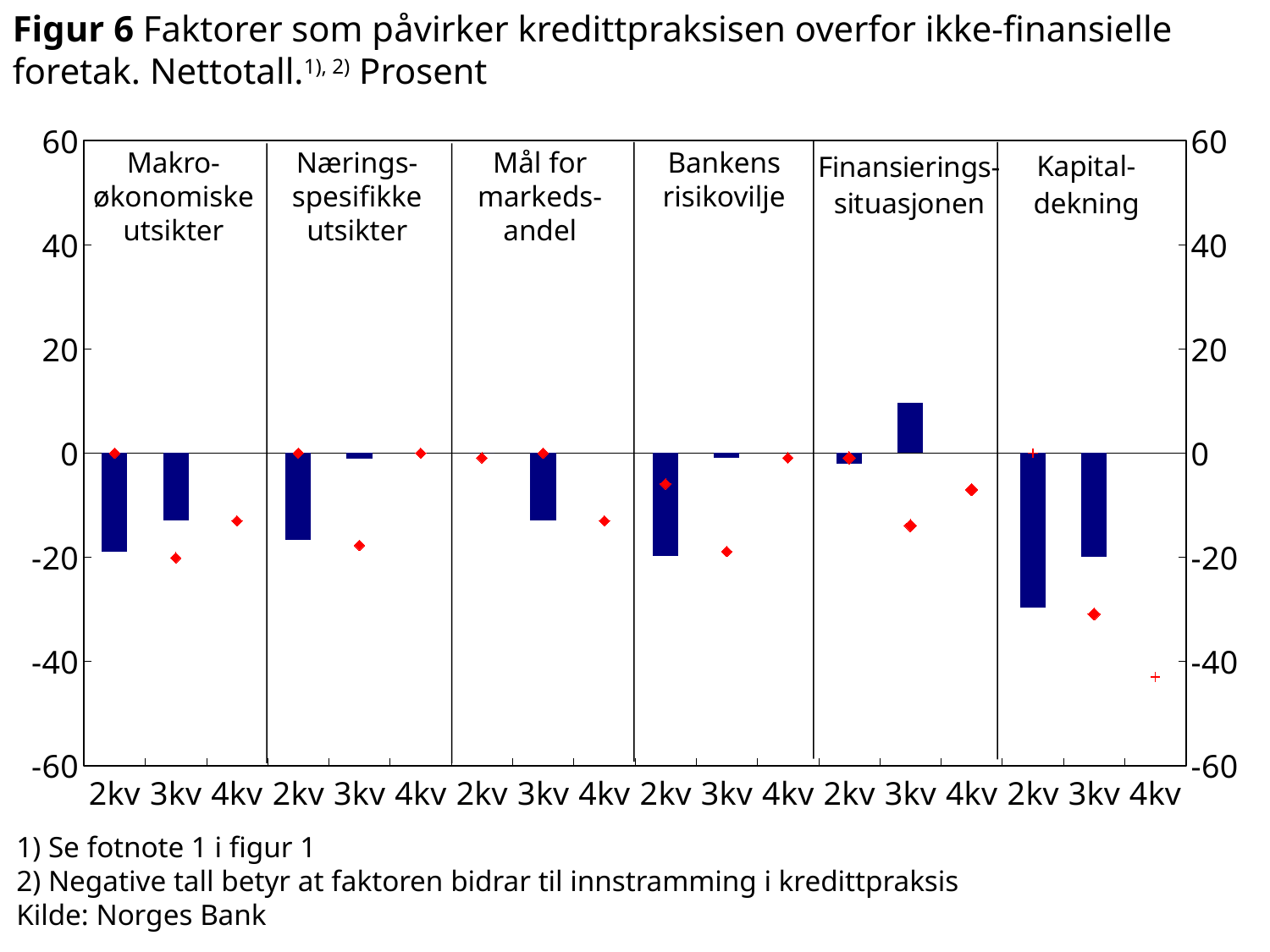
What kind of chart is shown in Figur 6? combination chart: bars with red diamond markers Which factor has the lowest 2kv bar? Kapitaldekning What is the range of the y axis on the chart? -60 to 60 Which 2kv bar is lower, Kapitaldekning or Bankens risikovilje? Kapitaldekning How many factor panels are shown along the x axis of the chart? 6 Within Makroøkonomiske utsikter, which bar is lower, 2kv or 3kv? 2kv Is the 4kv marker for Kapitaldekning greater or less than -40? less Which factor has the highest 3kv bar? Finansieringssituasjonen Is the 3kv bar for Finansieringssituasjonen greater or less than 0? greater Is the 2kv bar for Kapitaldekning greater or less than -20? less What source is given for the chart? Norges Bank